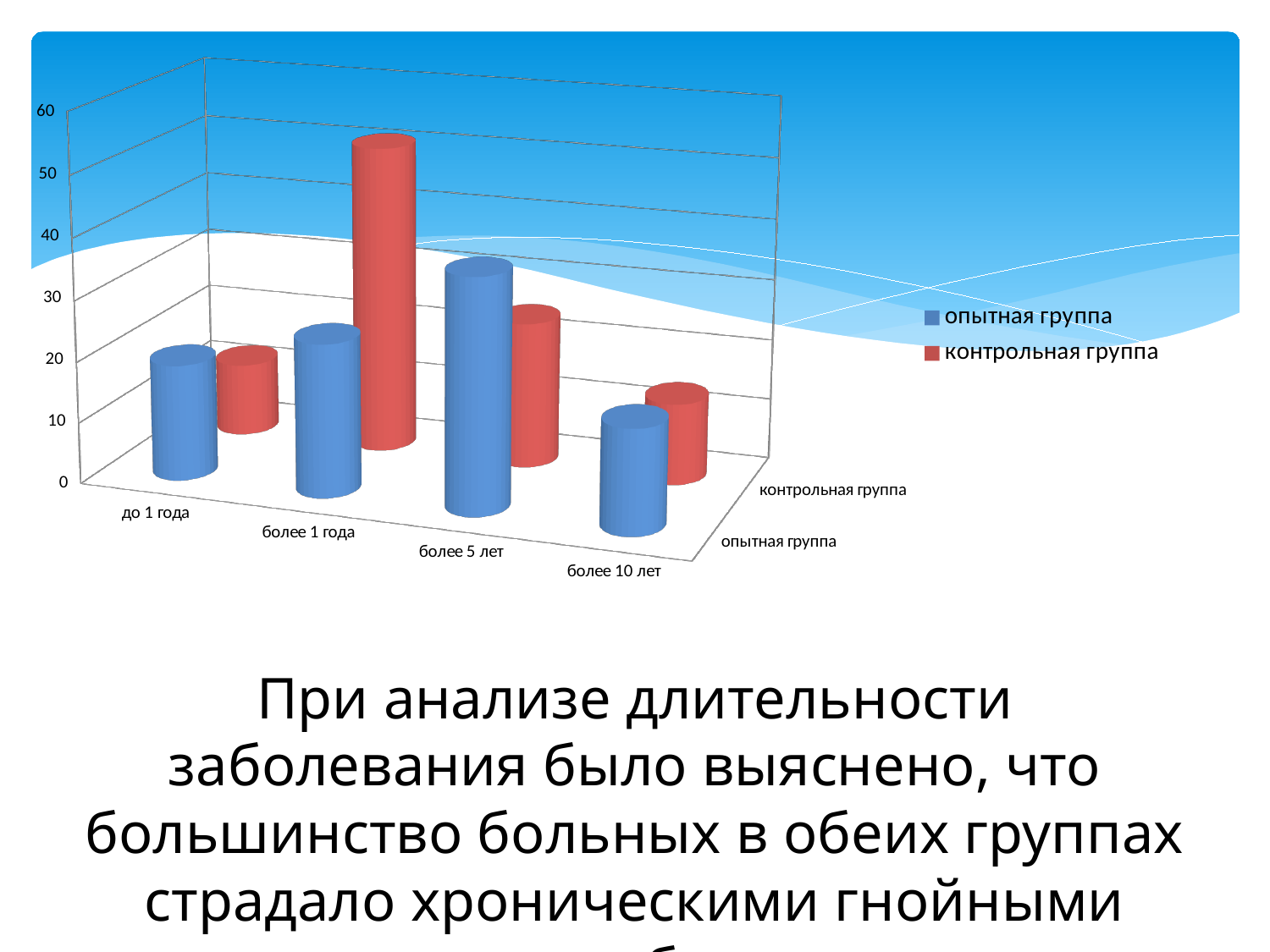
Which category has the lowest value for the опытная группа series? более 10 лет Is the value for опытная группа in the category более 10 лет greater or less than 30? less Which colour represents the контрольная группа series in the legend? red For the опытная группа series, which is larger: более 5 лет or более 10 лет? более 5 лет Is the value for опытная группа in the category более 5 лет greater or less than 30? greater Which category has the highest value for the опытная группа series? более 5 лет How many categories are shown along the x axis? 4 Which category has the highest value for the контрольная группа series? более 1 года Is the value for контрольная группа in the category более 1 года greater or less than 40? greater How many series does the legend list? 2 For the контрольная группа series, which is larger: более 1 года or более 5 лет? более 1 года What kind of chart is shown on the slide? bar chart